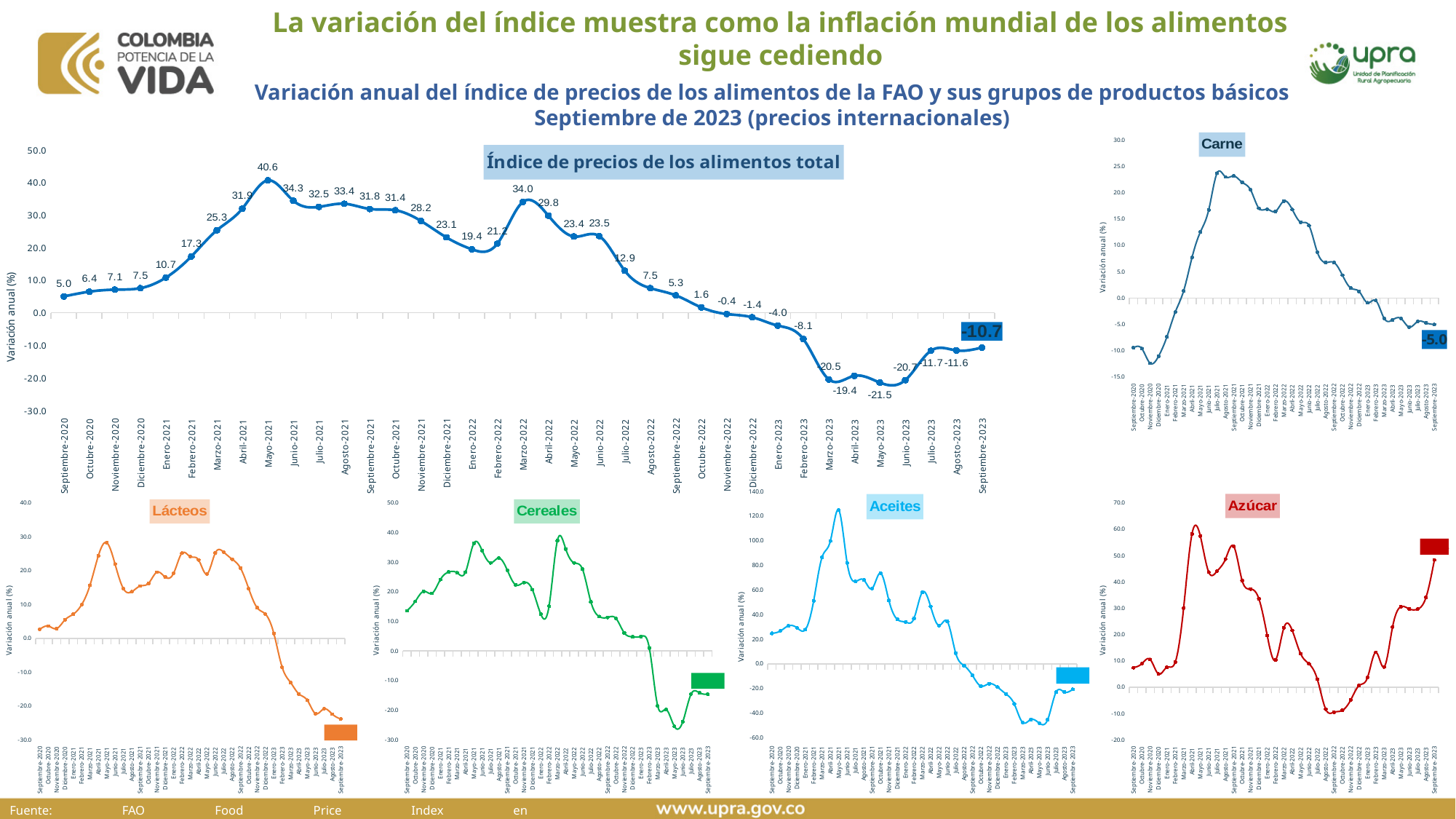
What are the titles of the five smaller commodity group charts on the slide? Carne, Lácteos, Cereales, Aceites, Azúcar What kind of chart is the 'Índice de precios de los alimentos total' chart? Line chart In the 'Índice de precios de los alimentos total' chart, do the values rise or fall from Marzo-2022 to Marzo-2023? Fall In the 'Índice de precios de los alimentos total' chart, what is the value for Septiembre-2023? -10.7 In the 'Carne' chart, what is the value for Septiembre-2023? -5.0 In the 'Índice de precios de los alimentos total' chart, which is larger, the value for Marzo-2022 or Abril-2022? Marzo-2022 In the 'Índice de precios de los alimentos total' chart, which month has the highest value? Mayo-2021 In the 'Índice de precios de los alimentos total' chart, which month has the lowest value? Mayo-2023 In the 'Índice de precios de los alimentos total' chart, what is the value for Mayo-2021? 40.6 In the 'Índice de precios de los alimentos total' chart, what is the difference between the values for Mayo-2021 and Septiembre-2020? 35.6 In the 'Azúcar' chart, is the value for Septiembre-2023 greater or less than 40.0? greater How many monthly data points are plotted in the 'Índice de precios de los alimentos total' chart? 37